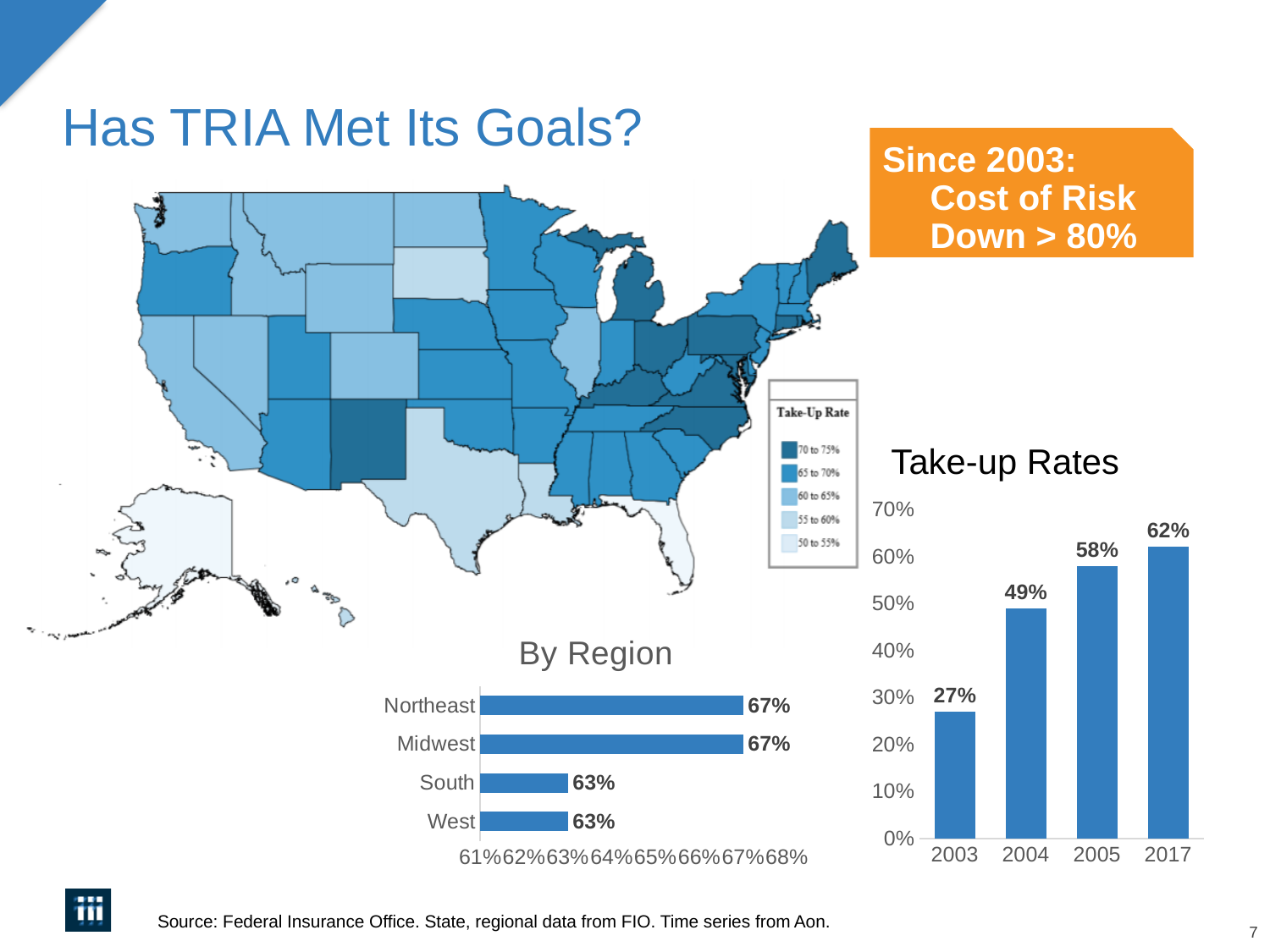
What kind of chart is the By Region chart? bar chart In the Take-up Rates chart, which year has the highest take-up rate? 2017 In the By Region chart, what is the take-up rate for the South? 63% In the By Region chart, what is the take-up rate for the Northeast? 67% In the Take-up Rates chart, what is the take-up rate for 2003? 27% In the Take-up Rates chart, what is the difference between the 2017 and 2003 take-up rates? 35% In the By Region chart, what is the difference between the Midwest and West take-up rates? 4% In the Take-up Rates chart, which year has the lowest take-up rate? 2003 In the By Region chart, which is larger, the value for the Midwest or the value for the South? Midwest In the Take-up Rates chart, do the values rise or fall from 2003 to 2017? rise In the Take-up Rates chart, what is the take-up rate for 2017? 62% How many years are shown in the Take-up Rates chart? 4